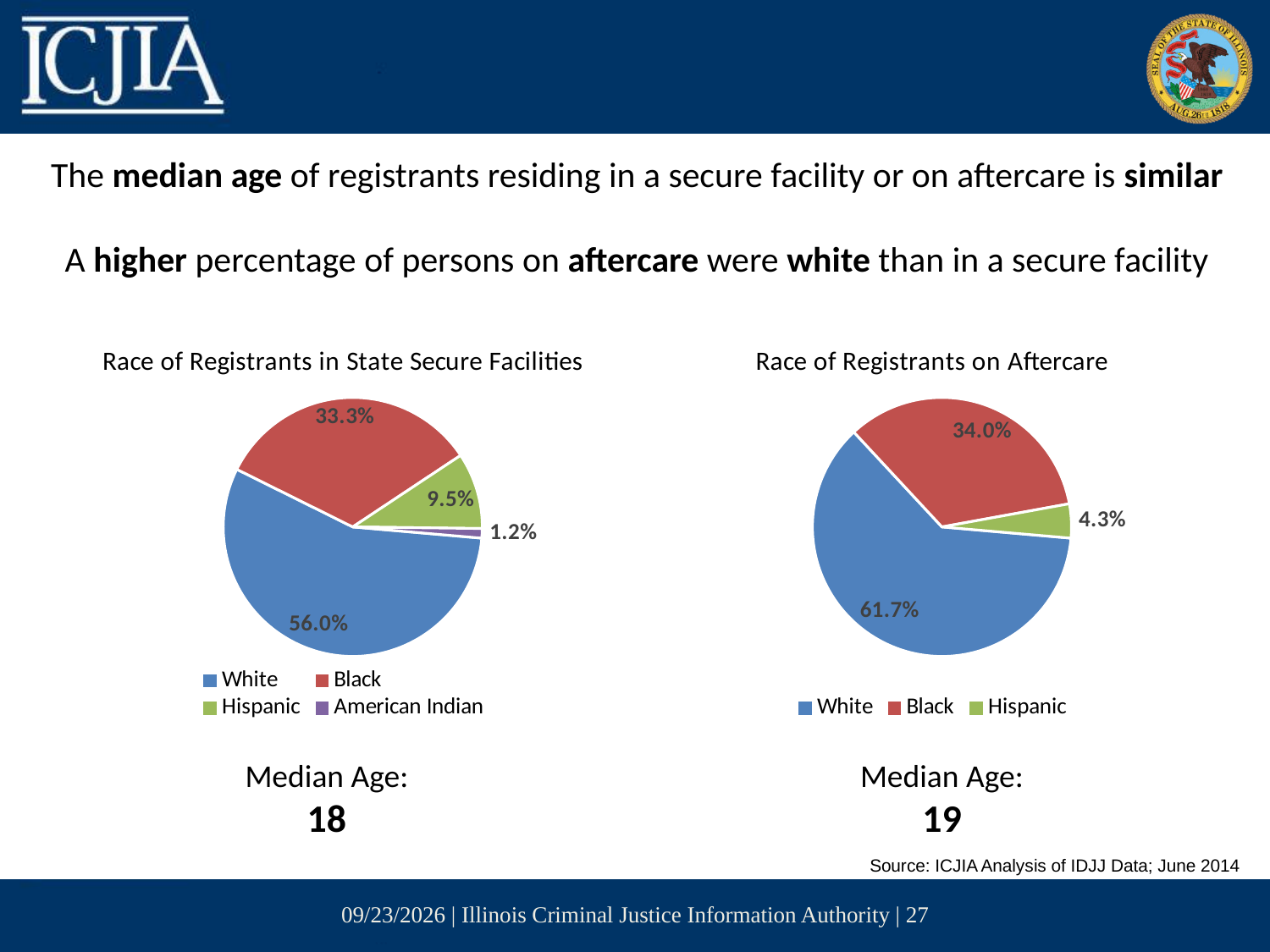
What is the difference between the White share in the 'Race of Registrants on Aftercare' chart and the White share in the 'Race of Registrants in State Secure Facilities' chart? 5.7% How many categories does the legend of the 'Race of Registrants on Aftercare' chart list? 3 In the 'Race of Registrants in State Secure Facilities' chart, what percentage of registrants are Hispanic? 9.5% In the 'Race of Registrants in State Secure Facilities' chart, what percentage of registrants are American Indian? 1.2% Is the Hispanic share larger in the 'Race of Registrants in State Secure Facilities' chart or in the 'Race of Registrants on Aftercare' chart? Race of Registrants in State Secure Facilities In the 'Race of Registrants in State Secure Facilities' chart, what percentage of registrants are White? 56.0% In the 'Race of Registrants on Aftercare' chart, what percentage of registrants are Black? 34.0% In the 'Race of Registrants in State Secure Facilities' chart, which race has the smallest share? American Indian How many categories does the legend of the 'Race of Registrants in State Secure Facilities' chart list? 4 What type of chart is used for 'Race of Registrants on Aftercare'? Pie chart In the 'Race of Registrants on Aftercare' chart, which race has the largest share? White In the 'Race of Registrants on Aftercare' chart, what percentage of registrants are Hispanic? 4.3%